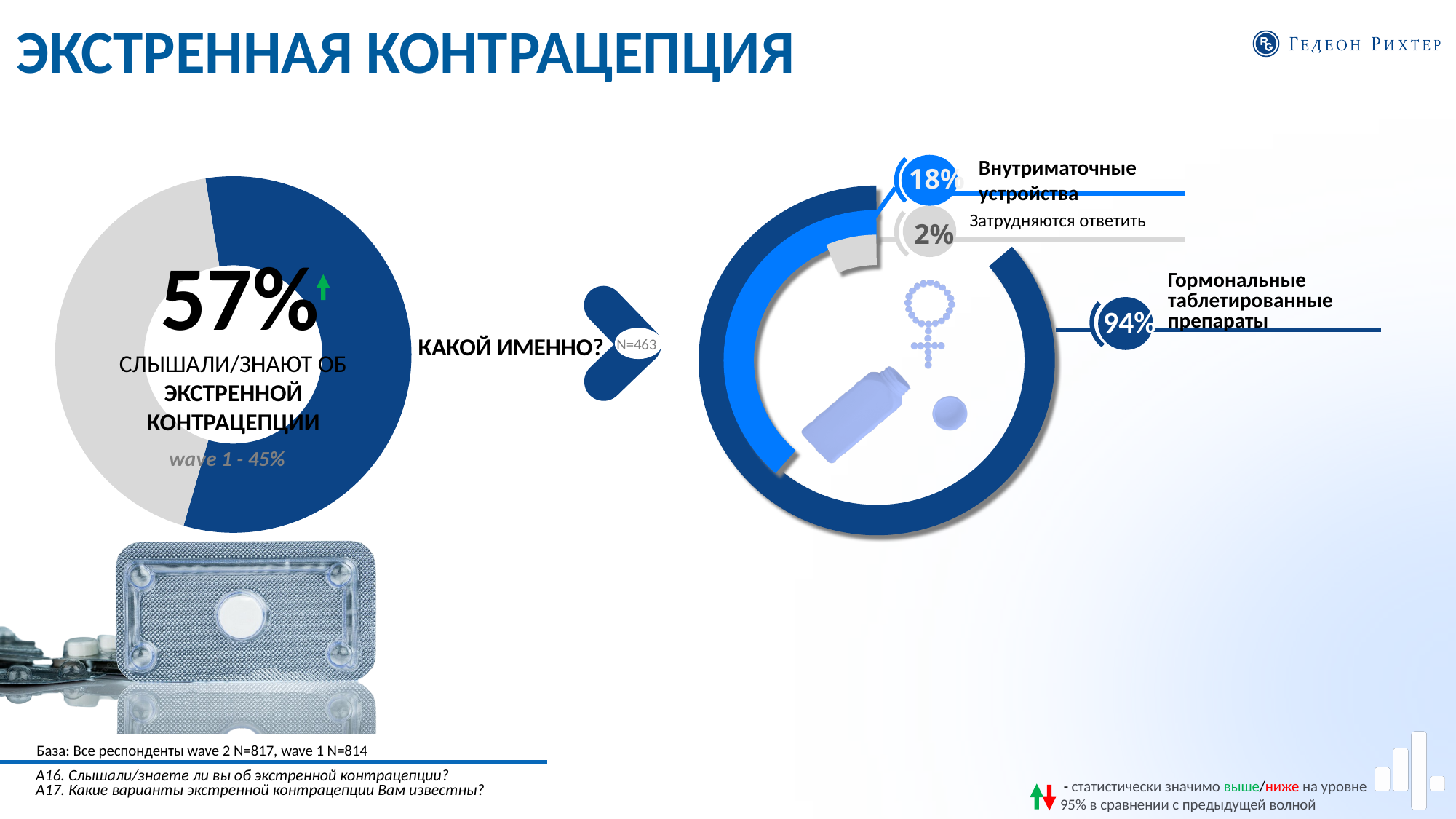
On the right ring chart (КАКОЙ ИМЕННО?), which category has the lowest value? Затрудняются ответить On the right ring chart (КАКОЙ ИМЕННО?), which category has the highest value? Гормональные таблетированные препараты On the right ring chart (КАКОЙ ИМЕННО?), what percentage is shown for Гормональные таблетированные препараты? 94% On the left donut chart, did awareness of emergency contraception rise or fall compared with wave 1? rise On the left donut chart, what was the awareness value in wave 1? 45% On the left donut chart, by how many percentage points did awareness of emergency contraception change from wave 1 (45%) to the current 57%? 12 percentage points How many categories are shown on the right ring chart (КАКОЙ ИМЕННО?)? 3 On the right ring chart (КАКОЙ ИМЕННО?), what is the difference between Гормональные таблетированные препараты and Внутриматочные устройства? 76 percentage points On the right ring chart (КАКОЙ ИМЕННО?), what percentage is shown for Внутриматочные устройства? 18% What is the sample size (N) indicated for the right ring chart (КАКОЙ ИМЕННО?)? N=463 On the right ring chart (КАКОЙ ИМЕННО?), what percentage is shown for Затрудняются ответить? 2% On the left donut chart, what percentage of respondents have heard of / know about emergency contraception? 57%